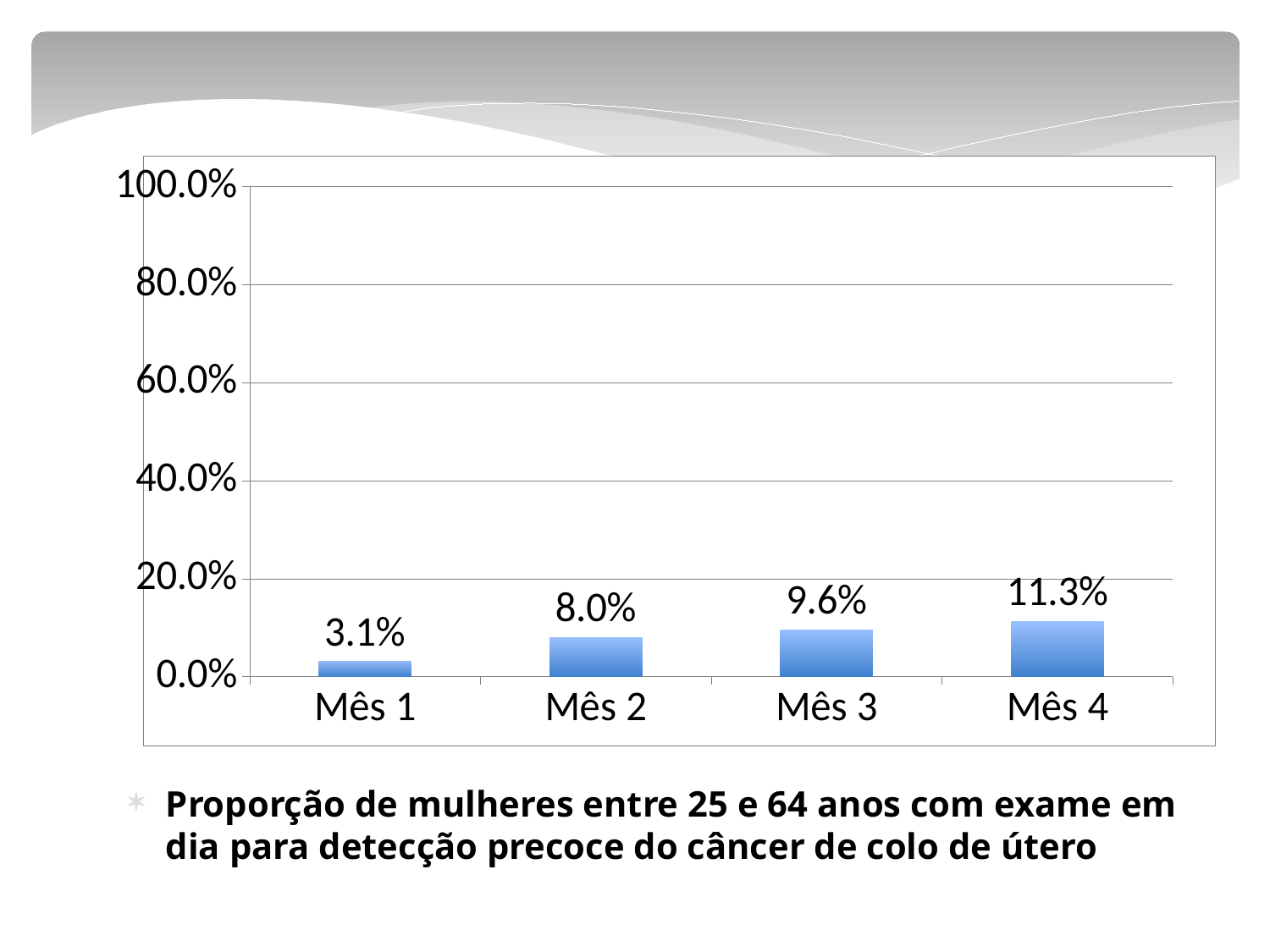
What kind of chart is shown? bar chart Which is larger, the value for Mês 2 or Mês 3? Mês 3 What is the value for Mês 1? 3.1% Which month has the highest value? Mês 4 How many categories are shown on the x axis? 4 Which month has the lowest value? Mês 1 What is the difference between the values for Mês 2 and Mês 1? 4.9% Is the value for Mês 4 greater or less than 20.0%? less What is the value for Mês 4? 11.3% What is the value for Mês 2? 8.0% What is the difference between the values for Mês 4 and Mês 1? 8.2% What is the value for Mês 3? 9.6%